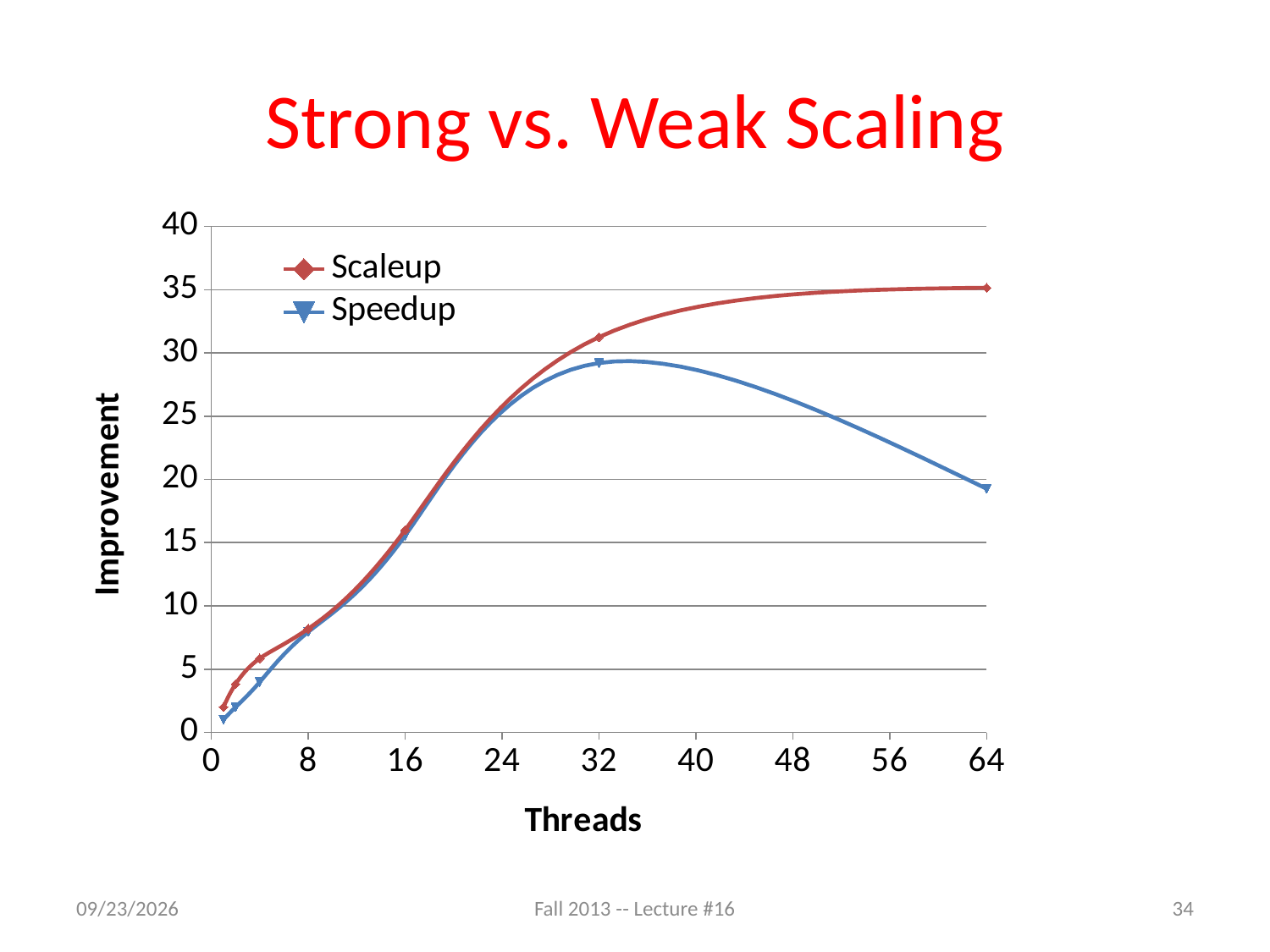
Is the Speedup value at 32 threads greater or less than 25? greater What are the two series named in the legend? Scaleup and Speedup What kind of chart is shown on the slide? line chart What is the label of the x axis? Threads How many series does the legend list? 2 Which series reaches the highest Improvement value on the chart? Scaleup At 64 threads, which series has the larger value, Scaleup or Speedup? Scaleup Is the Speedup value at 64 threads greater or less than 25? less Is the Scaleup value at 64 threads greater or less than 30? greater Does the Speedup series keep rising as the number of threads increases from 32 to 64, or does it fall? falls How many data points are plotted for the Scaleup series? 7